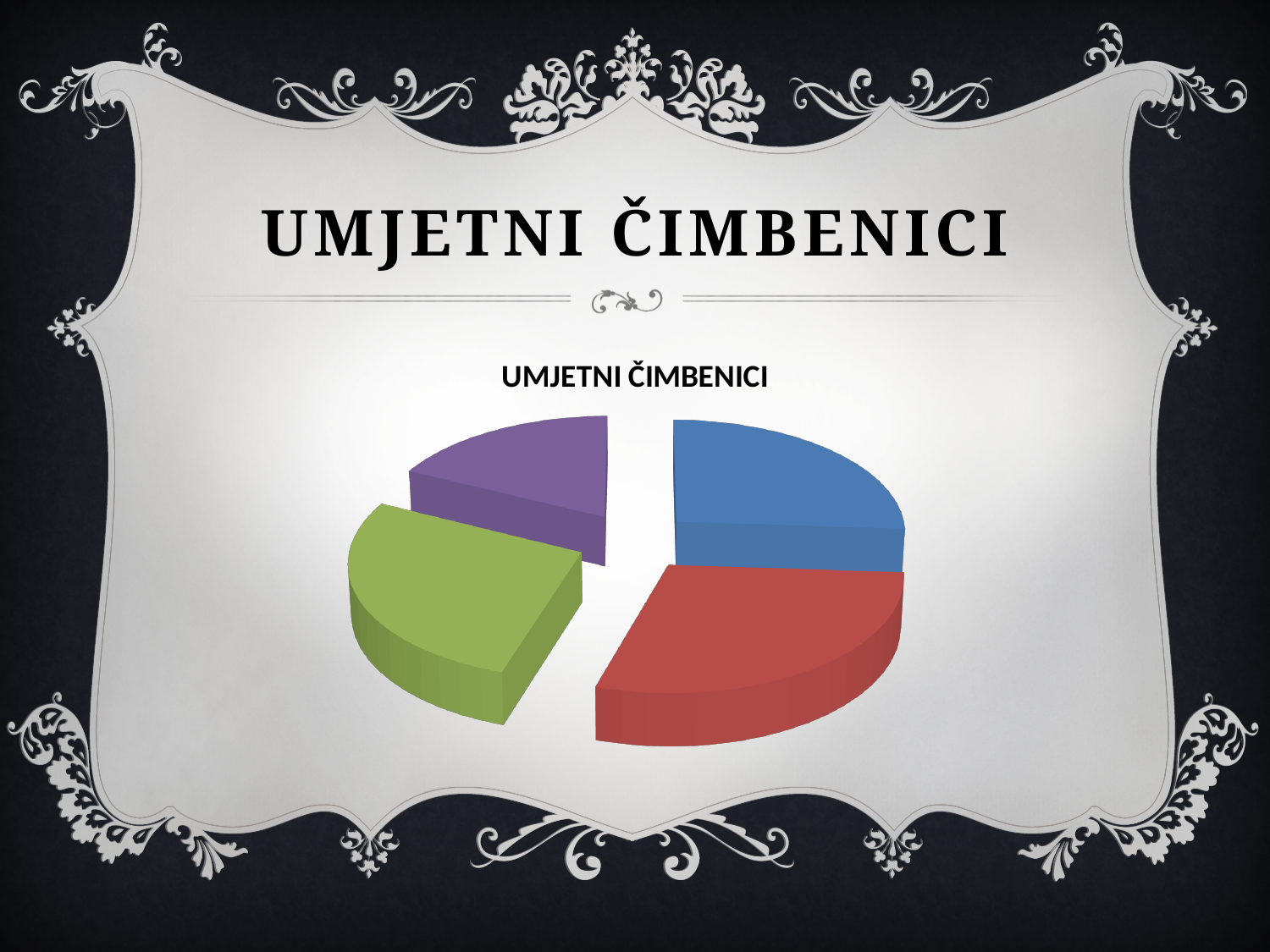
What kind of chart is shown on the slide? pie chart Which slice is larger in the pie chart, the red one or the purple one? red Which colour slice is the largest in the pie chart? red How many slices does the pie chart have? 4 What is the title of the pie chart? UMJETNI ČIMBENICI Which colour slice is the smallest in the pie chart? purple Does the pie chart display a legend? No